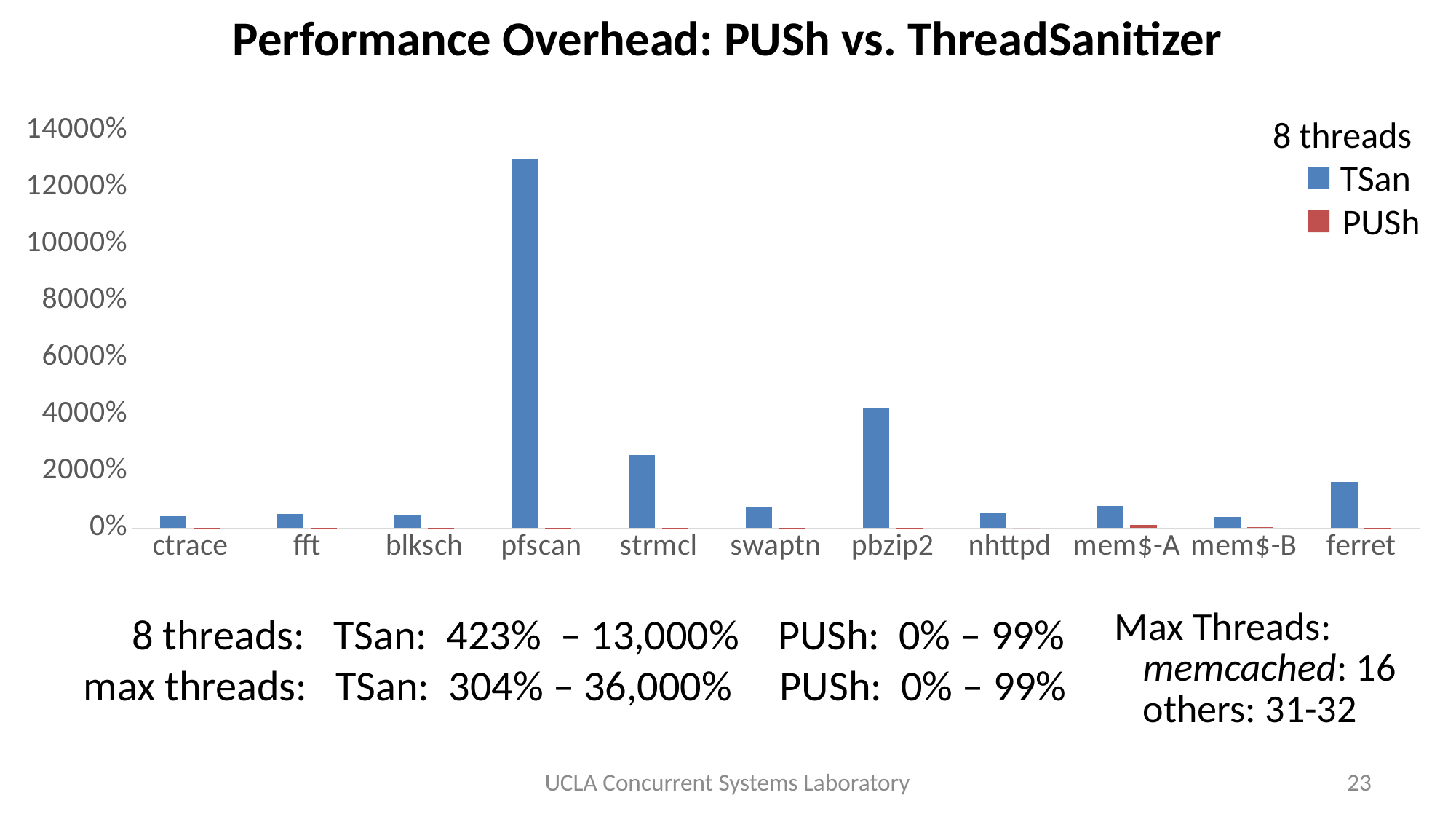
Is the TSan value for ferret greater or less than 2000%? less How many series does the chart legend list? 2 Which has the larger TSan overhead, ferret or swaptn? ferret Is the TSan value for strmcl greater or less than 2000%? greater What colour are the TSan bars in the chart? blue How many benchmark categories are shown on the x axis? 11 What kind of chart is shown on the slide? bar chart Is the TSan value for pfscan greater or less than 12000%? greater What is the title of the chart? Performance Overhead: PUSh vs. ThreadSanitizer Which has the larger TSan overhead, pbzip2 or strmcl? pbzip2 Which benchmark has the highest TSan overhead? pfscan